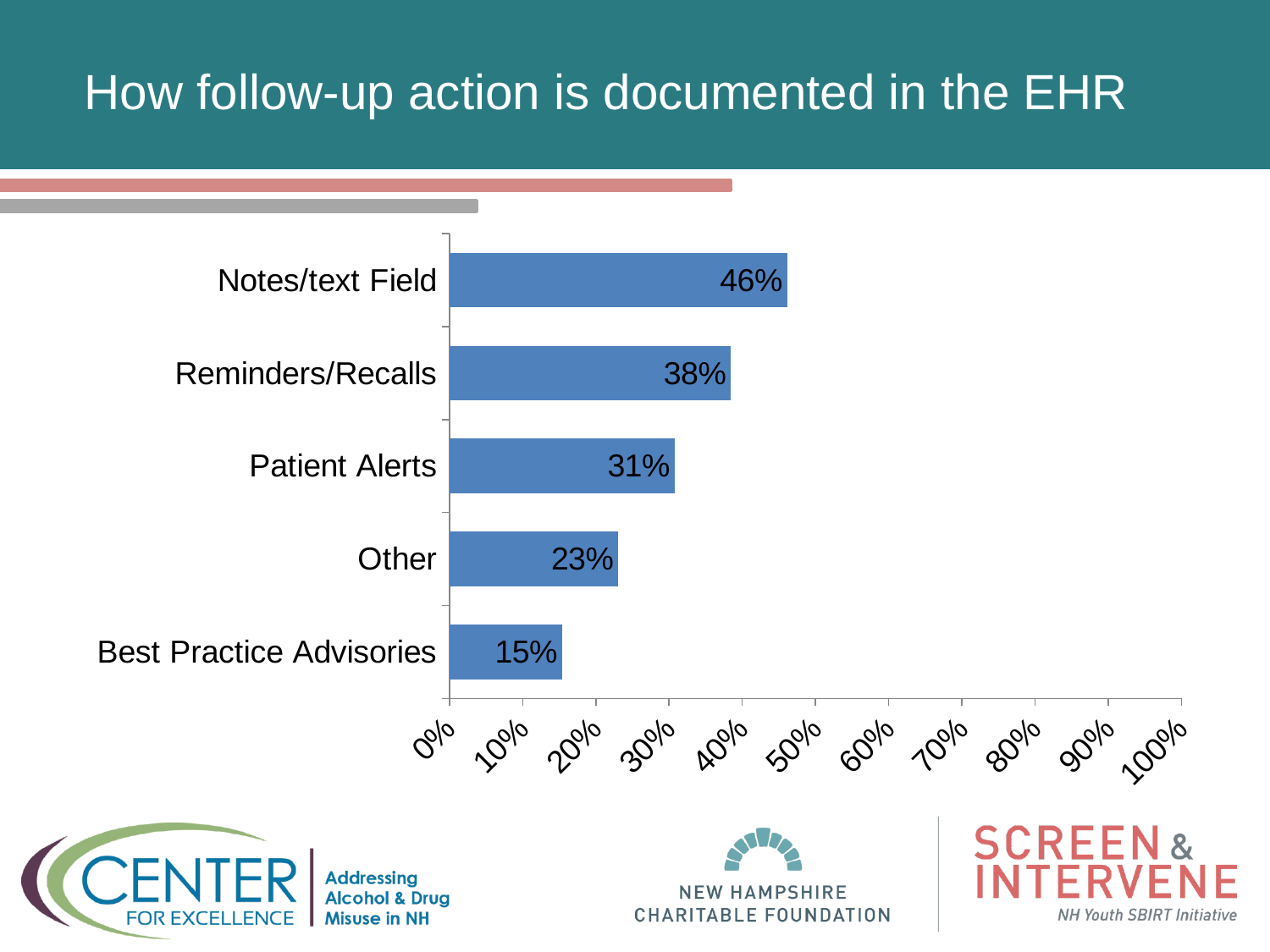
Is the value for Reminders/Recalls greater or less than 40%? less What is the value for Reminders/Recalls? 38% What percentage is shown for Patient Alerts? 31% What is the difference between the values for Notes/text Field and Reminders/Recalls? 8% What is the value for Best Practice Advisories? 15% Which category has the lowest value? Best Practice Advisories Which is larger, the value for Patient Alerts or the value for Other? Patient Alerts Which category has the highest value? Notes/text Field How many categories are shown in the chart? 5 What percentage is shown for Notes/text Field? 46% What kind of chart is shown on the slide? Bar chart What is the difference between the values for Other and Best Practice Advisories? 8%